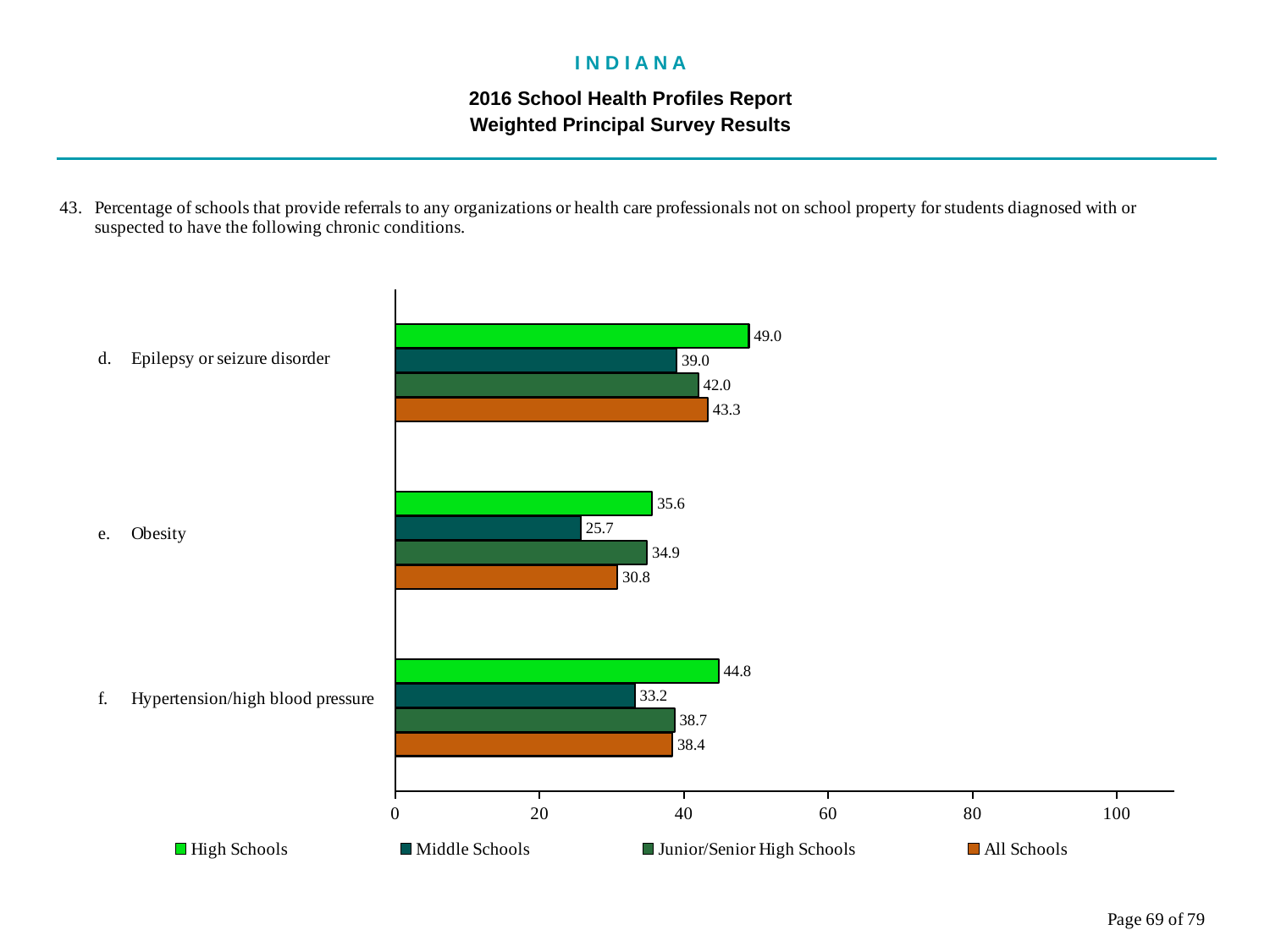
What is the value for High Schools for Epilepsy or seizure disorder? 49.0 Is the value for Middle Schools for Epilepsy or seizure disorder greater or less than 40? less What is the value for Middle Schools for Obesity? 25.7 Which chronic condition has the highest value for High Schools? Epilepsy or seizure disorder What is the value for Junior/Senior High Schools for Epilepsy or seizure disorder? 42.0 What is the value for All Schools for Hypertension/high blood pressure? 38.4 How many chronic conditions are shown on the chart? 3 Which is larger for Obesity: the High Schools value or the All Schools value? High Schools Which chronic condition has the lowest value for Middle Schools? Obesity What is the difference between the High Schools and Middle Schools values for Hypertension/high blood pressure? 11.6 What kind of chart is shown on the slide? bar chart How many series does the legend list? 4